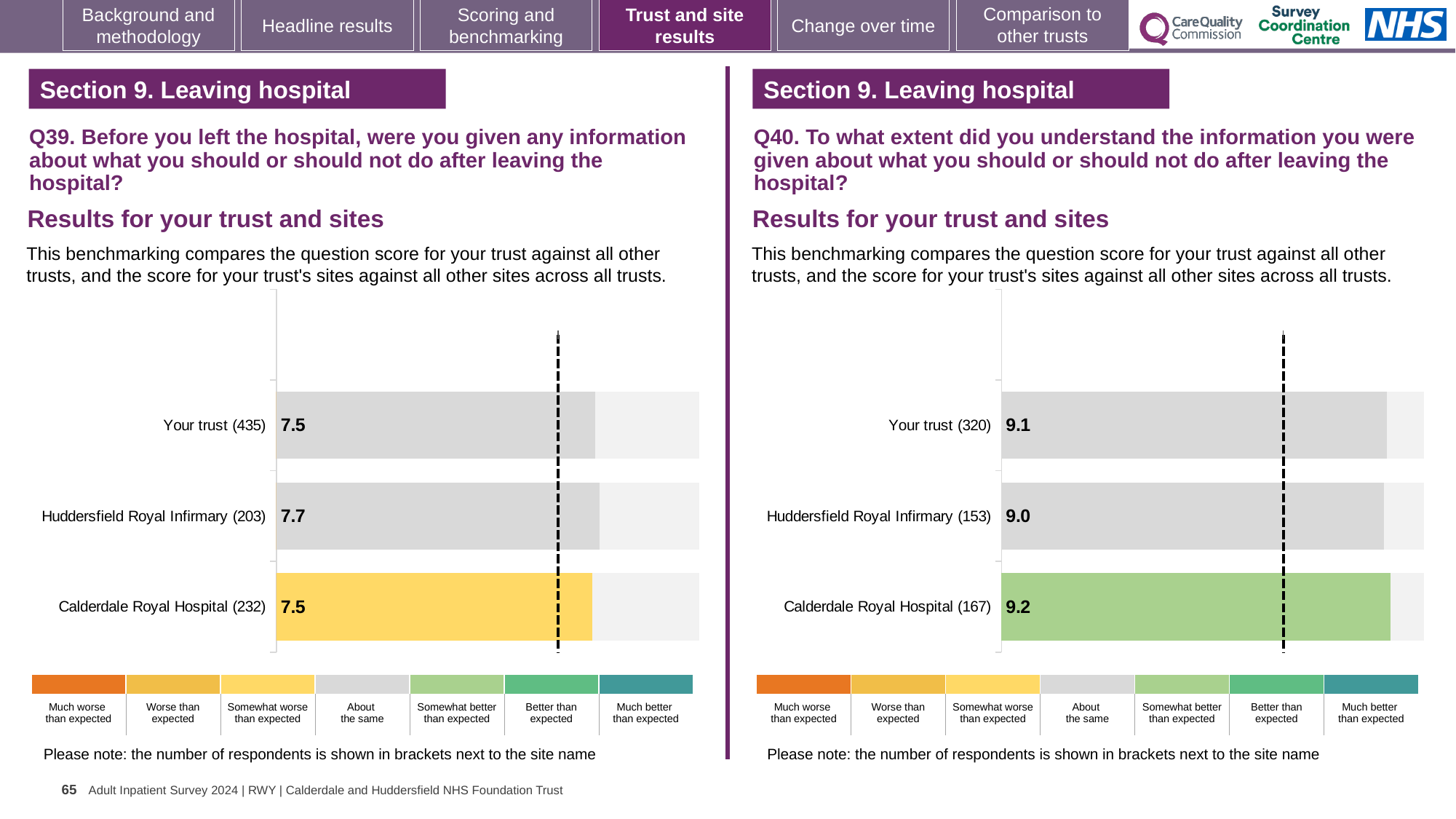
In the Q39 chart on the left, how many respondents are shown in brackets for Calderdale Royal Hospital? 232 What type of chart is used for the Q40 results on the right? Bar chart How many bars are plotted in the Q39 chart on the left? 3 In the Q40 chart on the right, what is the score for Huddersfield Royal Infirmary? 9.0 In the Q40 chart on the right, what is the difference between the scores for Calderdale Royal Hospital and Your trust? 0.1 In the Q39 chart on the left, what is the difference between the scores for Huddersfield Royal Infirmary and Calderdale Royal Hospital? 0.2 In the Q40 chart on the right, which has the higher score, Calderdale Royal Hospital or Huddersfield Royal Infirmary? Calderdale Royal Hospital In the Q39 chart on the left, what is the score for Your trust? 7.5 In the Q40 chart on the right, what is the score for Calderdale Royal Hospital? 9.2 In the Q39 chart on the left, which site or trust has the highest score? Huddersfield Royal Infirmary In the Q39 chart on the left, what is the score for Huddersfield Royal Infirmary? 7.7 In the Q40 chart on the right, which site or trust has the lowest score? Huddersfield Royal Infirmary